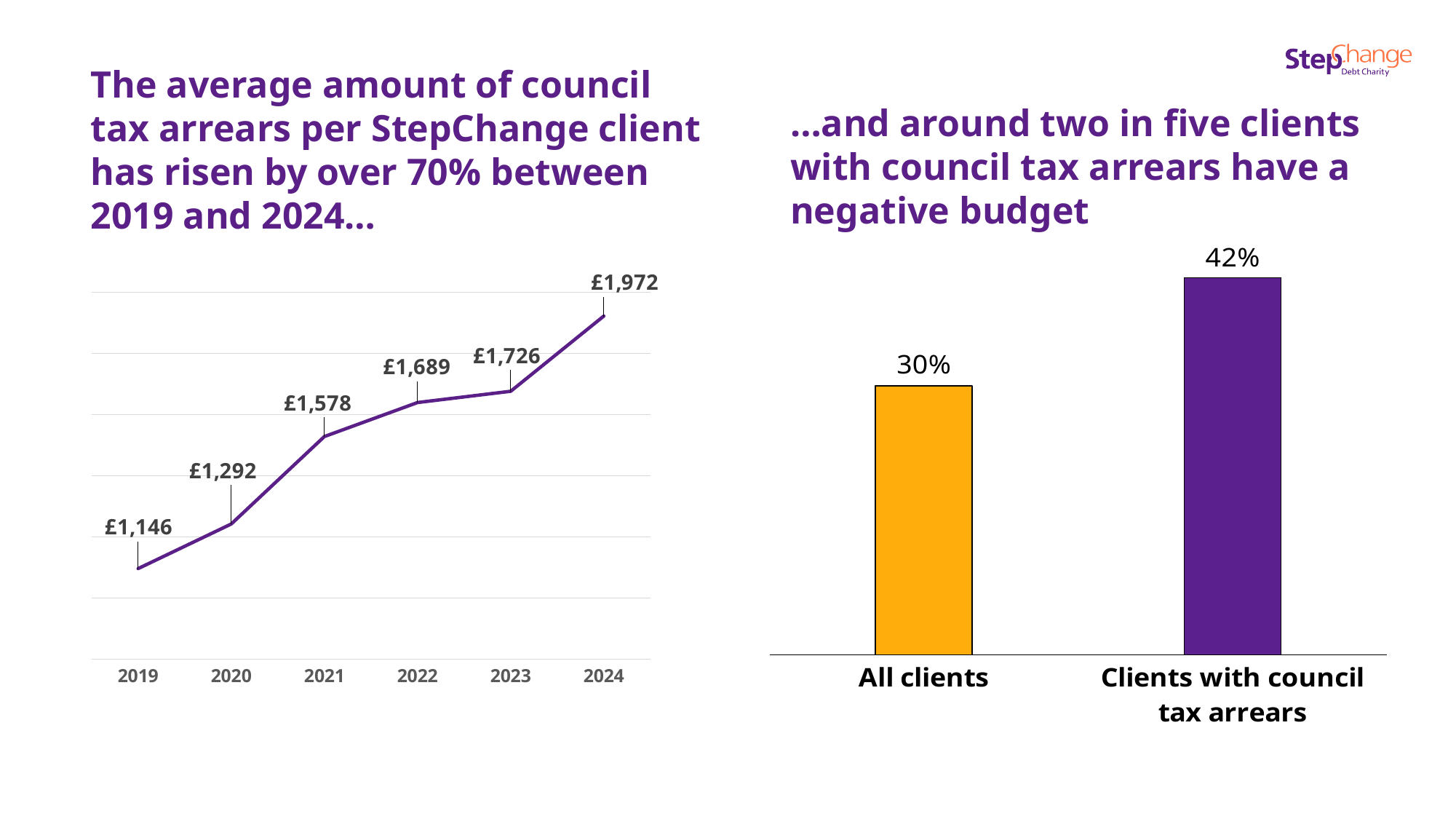
What kind of chart is on the left of the slide? line chart In the left-hand line chart, what was the average council tax arrears per client in 2022? £1,689 In the left-hand line chart, which year has the lowest average council tax arrears? 2019 In the right-hand bar chart, what percentage of clients with council tax arrears have a negative budget? 42% In the left-hand line chart, what was the average council tax arrears per client in 2024? £1,972 In the left-hand line chart, what is the difference between the 2024 and 2019 values? £826 In the right-hand bar chart, what is the difference between the value for clients with council tax arrears and the value for all clients? 12% In the left-hand line chart, which year has the highest average council tax arrears? 2024 In the left-hand line chart, do the values rise or fall from 2019 to 2024? rise In the left-hand line chart, what was the average council tax arrears per client in 2019? £1,146 In the left-hand line chart, how many years are plotted? 6 In the right-hand bar chart, which category has the larger value: All clients or Clients with council tax arrears? Clients with council tax arrears